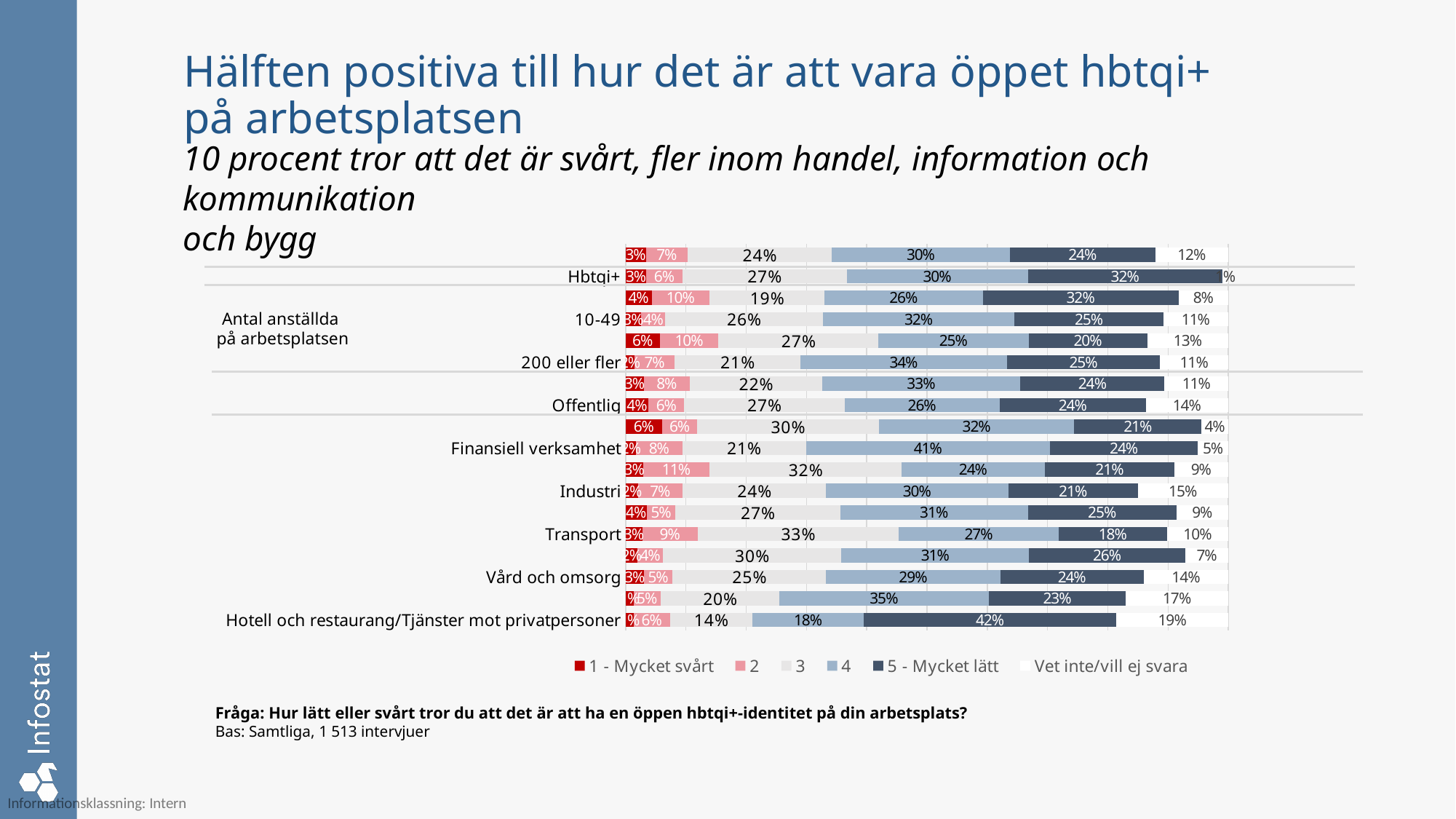
How many series does the chart legend list? 6 What is the value of the '3' segment for Transport? 33% What is the value of the '5 - Mycket lätt' segment for Hotell och restaurang/Tjänster mot privatpersoner? 42% Which is larger, the '4' segment for Finansiell verksamhet or for Transport? Finansiell verksamhet What is the 'Vet inte/vill ej svara' value for Industri? 15% What is the difference between the '5 - Mycket lätt' values for Hotell och restaurang/Tjänster mot privatpersoner and Industri? 21 percentage points What is the value of the '4' segment for 200 eller fler? 34% Which category has the highest '5 - Mycket lätt' value? Hotell och restaurang/Tjänster mot privatpersoner What is the first entry in the chart legend? 1 - Mycket svårt What is the 'Vet inte/vill ej svara' value for Offentlig? 14% What kind of chart is shown on the slide? Stacked bar chart What is the value of the '4' segment for Finansiell verksamhet? 41%